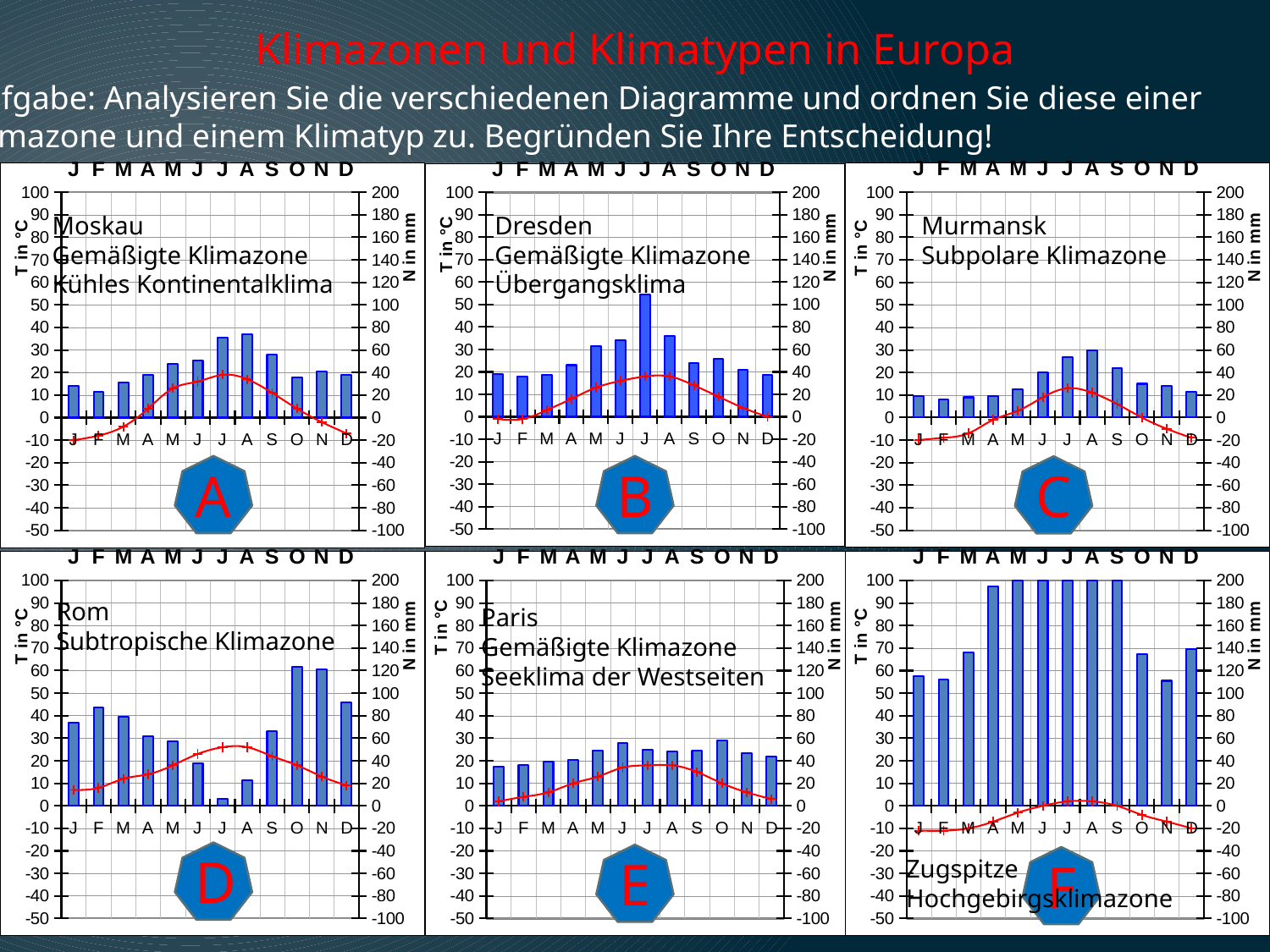
In the Rom chart (D), is the August temperature greater or less than 20 °C? greater In the Dresden chart (B), is the precipitation for July greater or less than 100 mm? greater In the Rom chart (D), does the temperature line rise or fall from January to July? rise In the Dresden chart (B), which month has the highest precipitation bar? July (J) What kind of chart is used for the precipitation values in the Moskau chart (A)? bar chart How many months (categories) are plotted along the x axis of the Dresden chart (B)? 12 In the Zugspitze chart (F), is the July temperature greater or less than 10 °C? less In the Dresden chart (B), which month has more precipitation, January or July? July In the Rom chart (D), which month has the lowest precipitation bar? July (J) Which climate zone is given for the Rom chart (D)? Subtropische Klimazone